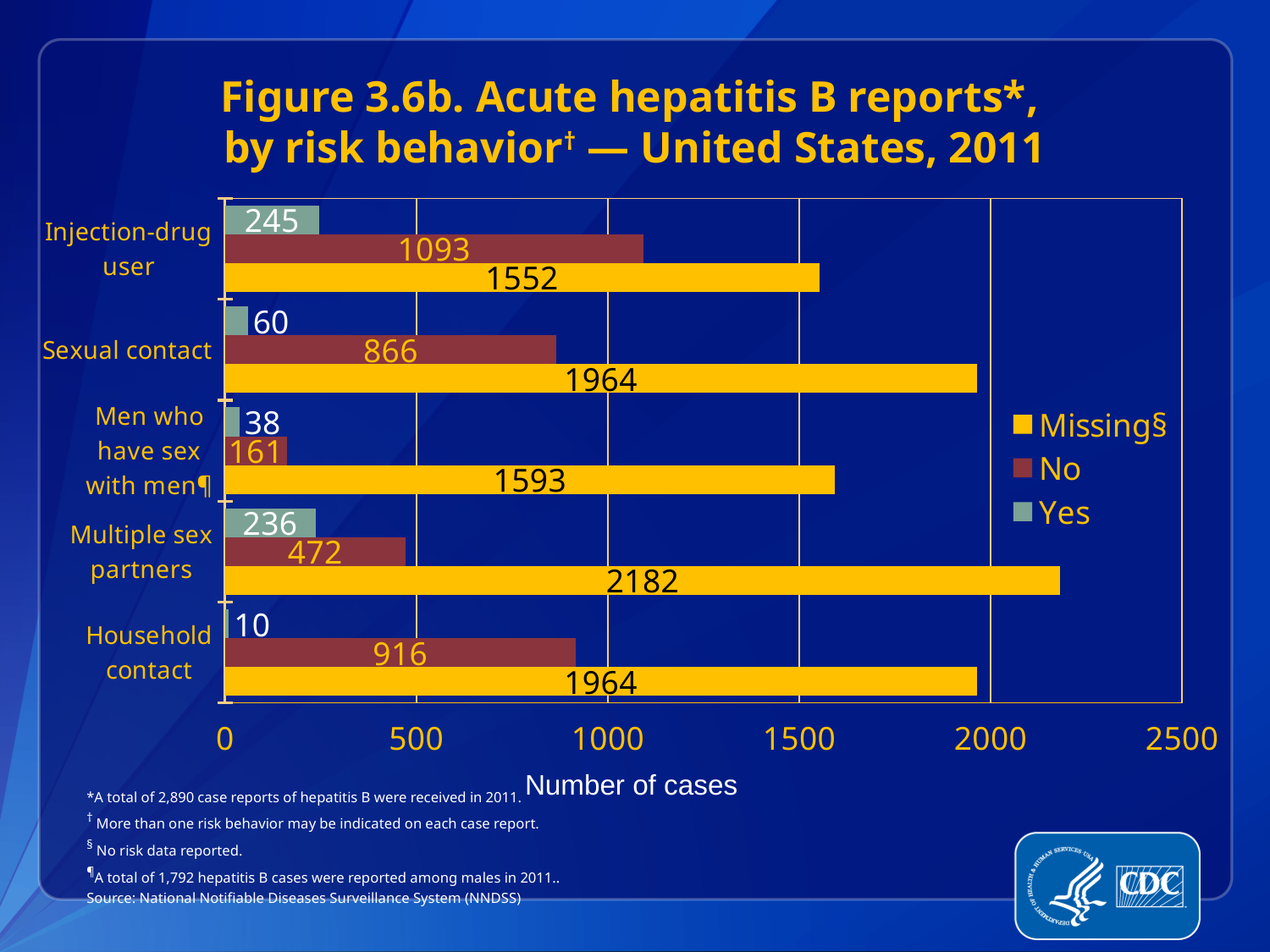
How many risk behavior categories are shown on the chart? 5 Which risk behavior has the lowest 'Yes' value? Household contact What is the label of the x axis? Number of cases What is the 'No' value for Household contact? 916 Is the 'Missing' value for Injection-drug user greater or less than 1500? greater What is the 'Missing' value for Multiple sex partners? 2182 What kind of chart is shown on the slide? Bar chart Which is larger, the 'Yes' value for Multiple sex partners or the 'Yes' value for Sexual contact? Multiple sex partners What is the difference between the 'No' values for Injection-drug user and Sexual contact? 227 How many series does the legend list? 3 Which risk behavior has the highest 'Yes' value? Injection-drug user What is the 'Yes' value for Injection-drug user? 245